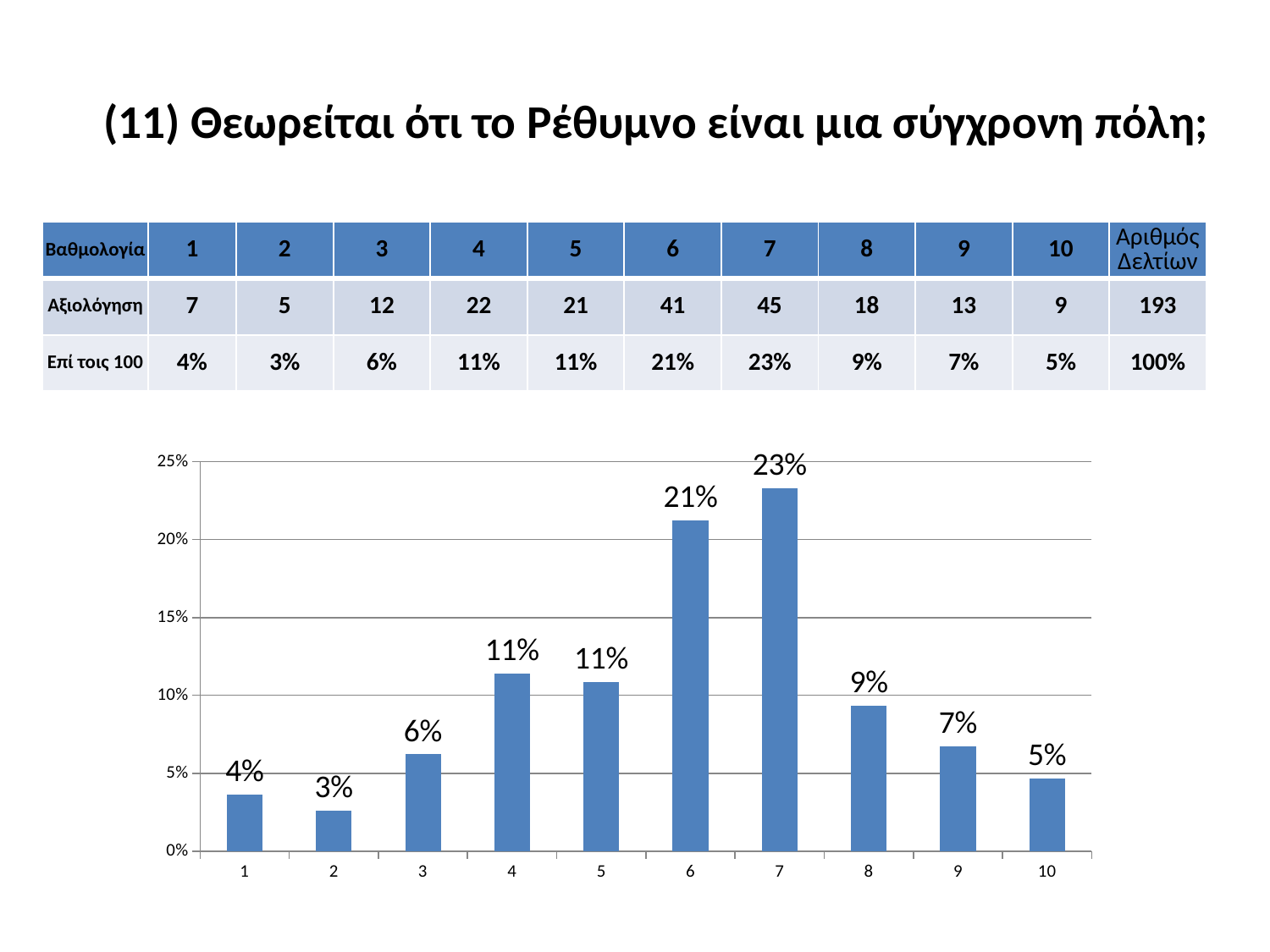
Is the value for category 6 greater or less than 20%? greater What is the value shown for category 9? 7% What is the value shown for category 7? 23% What kind of chart is shown on the slide? bar chart How many categories are shown on the x axis? 10 What is the difference between the values for category 6 and category 3? 15% What is the value shown for category 2? 3% What is the difference between the values for category 7 and category 6? 2% Which category has the lowest value? 2 Which is larger, the value for category 8 or the value for category 10? 8 Which category has the highest value? 7 Do the values rise or fall from category 7 to category 10? fall